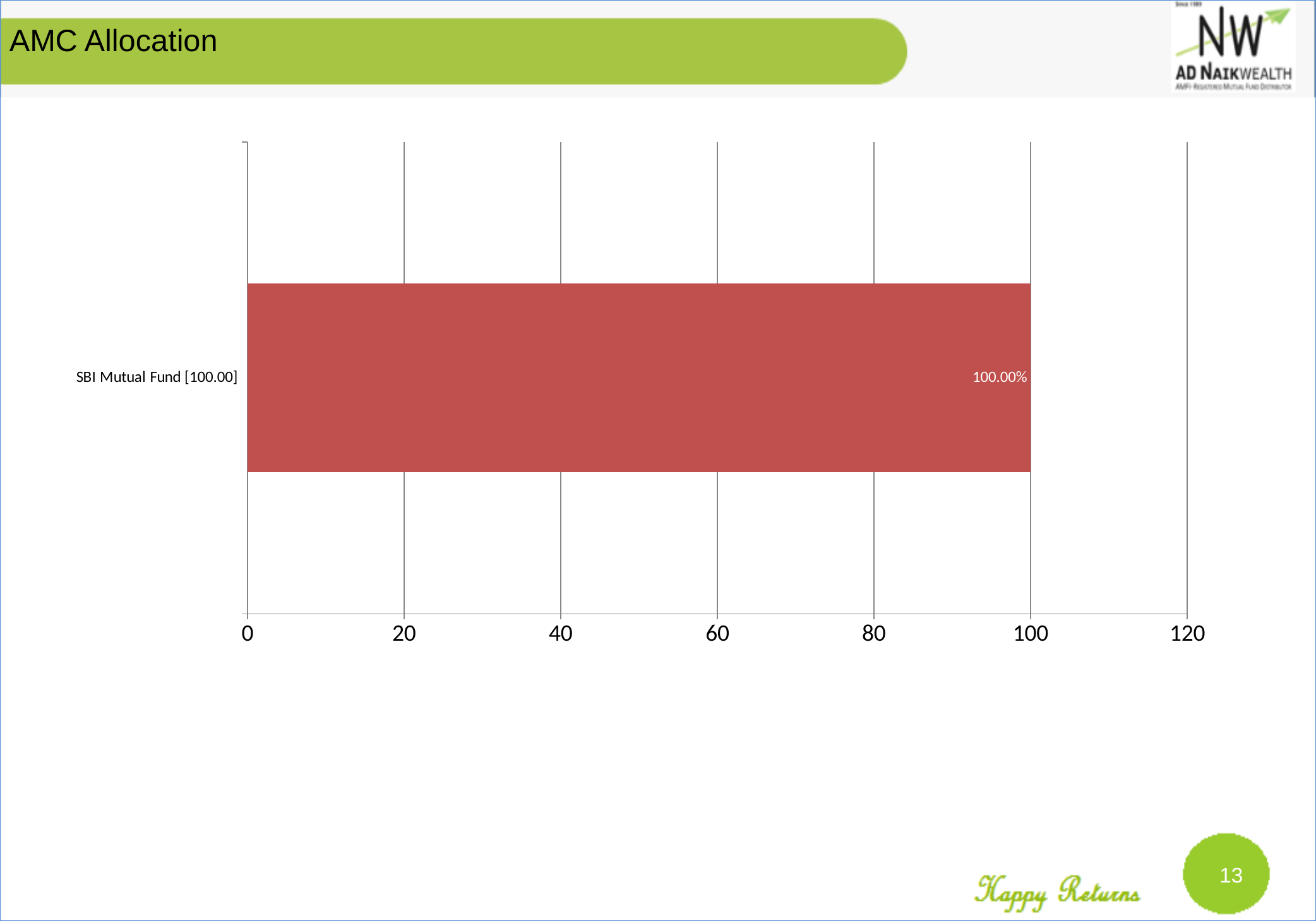
What kind of chart is shown on the AMC Allocation slide? bar chart Which category has the highest value on the AMC Allocation chart? SBI Mutual Fund [100.00] What is the highest value shown on the x axis of the AMC Allocation chart? 120 What is the value shown for SBI Mutual Fund [100.00] on the AMC Allocation chart? 100.00% What is the title of the slide containing the chart? AMC Allocation Is the value for SBI Mutual Fund [100.00] greater or less than 120? less Is the value for SBI Mutual Fund [100.00] greater or less than 80? greater How many categories are plotted on the AMC Allocation chart? 1